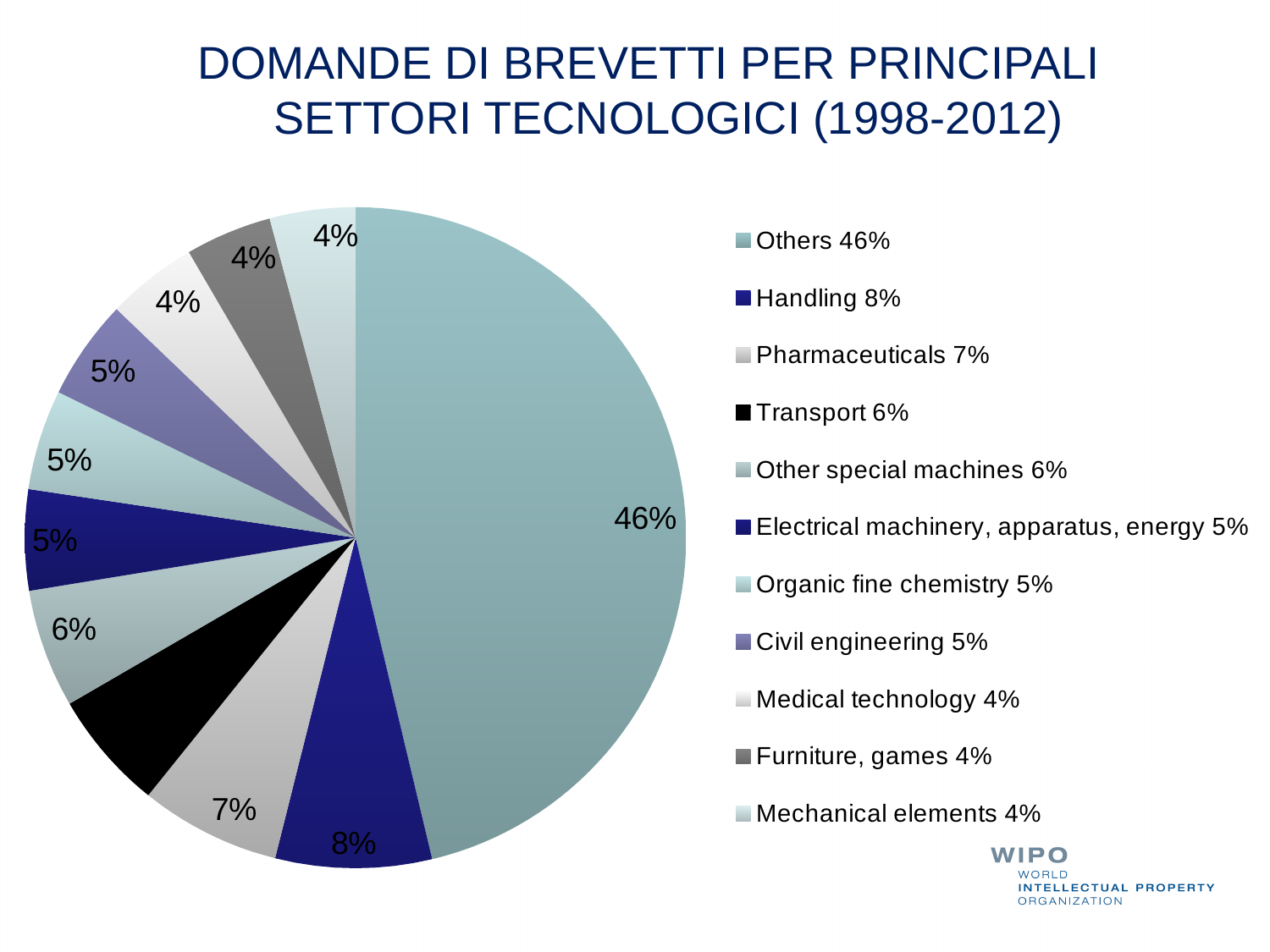
How many categories does the legend list? 11 Which is larger, Transport or Medical technology? Transport What is the value for Handling? 8% Which category has the largest slice of the pie? Others What kind of chart is shown on the slide? pie chart What is the combined share of Handling and Pharmaceuticals? 15% What share of patent applications does the Others slice represent? 46% What is the value for Pharmaceuticals? 7% What is the difference between Pharmaceuticals and Mechanical elements? 3% What is the difference between the Others slice and the Handling slice? 38% What is the title of the chart on the slide? DOMANDE DI BREVETTI PER PRINCIPALI SETTORI TECNOLOGICI (1998-2012) What is the value for Civil engineering? 5%